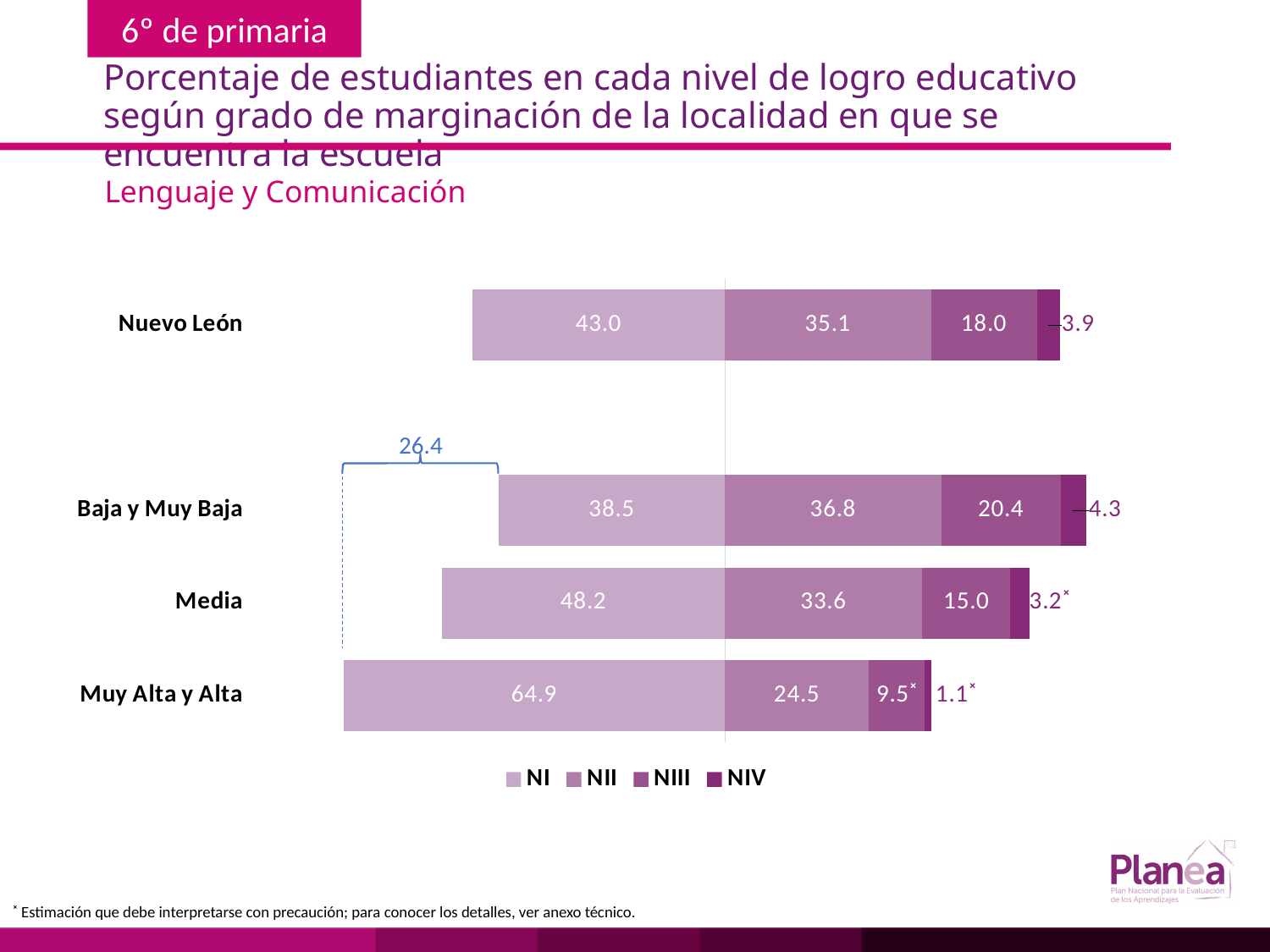
Which has a larger NII value, Baja y Muy Baja or Nuevo León? Baja y Muy Baja How many series does the legend list? 4 What is the NIV value for Baja y Muy Baja? 4.3 How many categories are shown on the chart? 4 What kind of chart is shown on the slide? Stacked bar chart Which category has the lowest NI value? Baja y Muy Baja What is the difference between the NIII value for Nuevo León and the NIII value for Media? 3.0 What is the difference between the NI value for Muy Alta y Alta and the NI value for Baja y Muy Baja? 26.4 Which category has the highest NI value? Muy Alta y Alta What is the NII value for the Media category? 33.6 What is the NI value for Nuevo León? 43.0 What is the NIII value for Muy Alta y Alta? 9.5